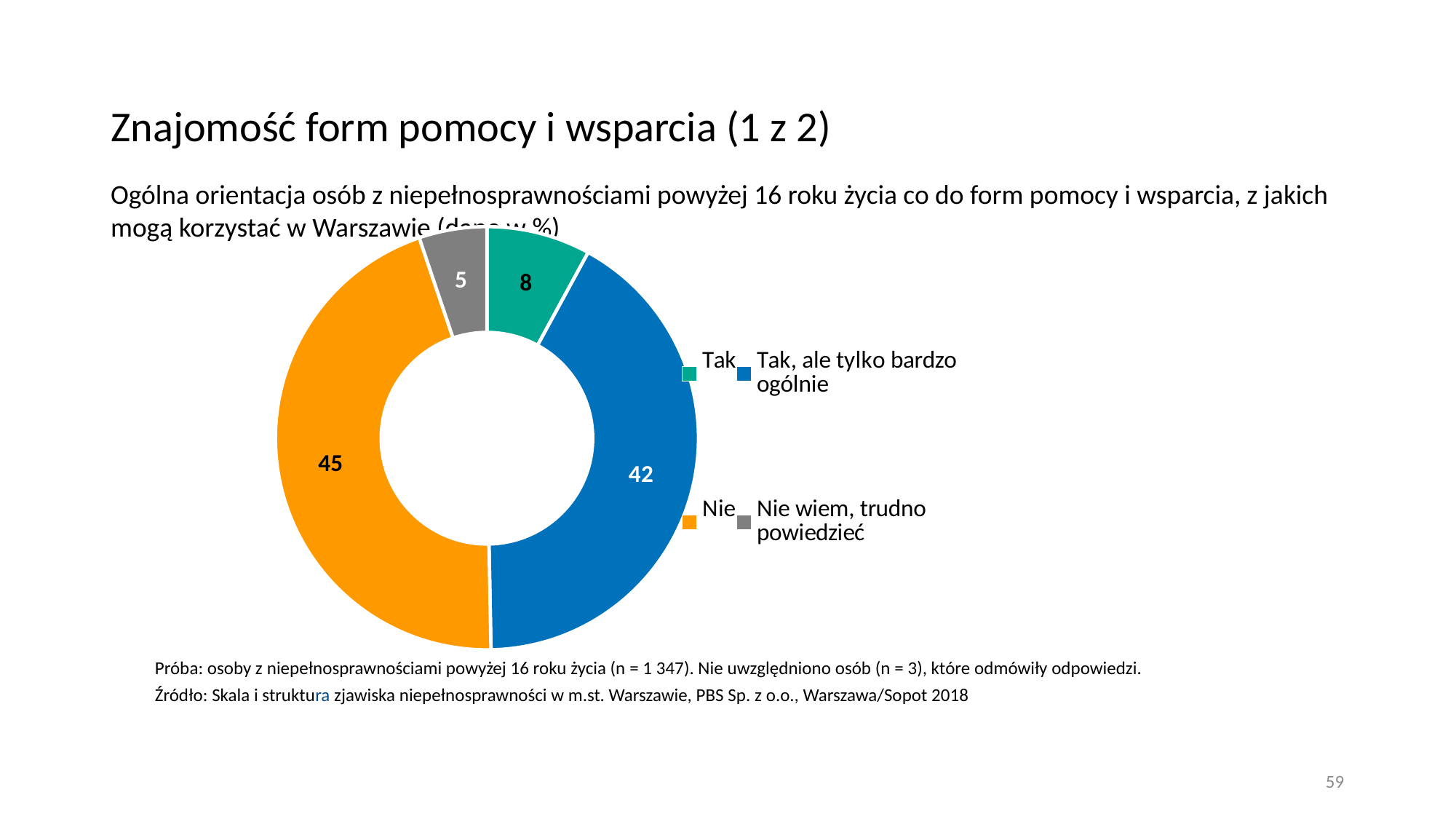
Which category has the largest slice? Nie Which is larger, the value for "Tak" or the value for "Nie wiem, trudno powiedzieć"? Tak What value is shown for the "Tak, ale tylko bardzo ogólnie" slice? 42 What colour is the "Nie" slice? Orange How many categories does the chart show? 4 What value is shown for the "Tak" slice? 8 Which category has the smallest slice? Nie wiem, trudno powiedzieć What value is shown for the "Nie wiem, trudno powiedzieć" slice? 5 What is the difference between the values for "Tak" and "Nie wiem, trudno powiedzieć"? 3 What value is shown for the "Nie" slice? 45 What is the difference between the values for "Nie" and "Tak, ale tylko bardzo ogólnie"? 3 What kind of chart is shown on the slide? Doughnut chart